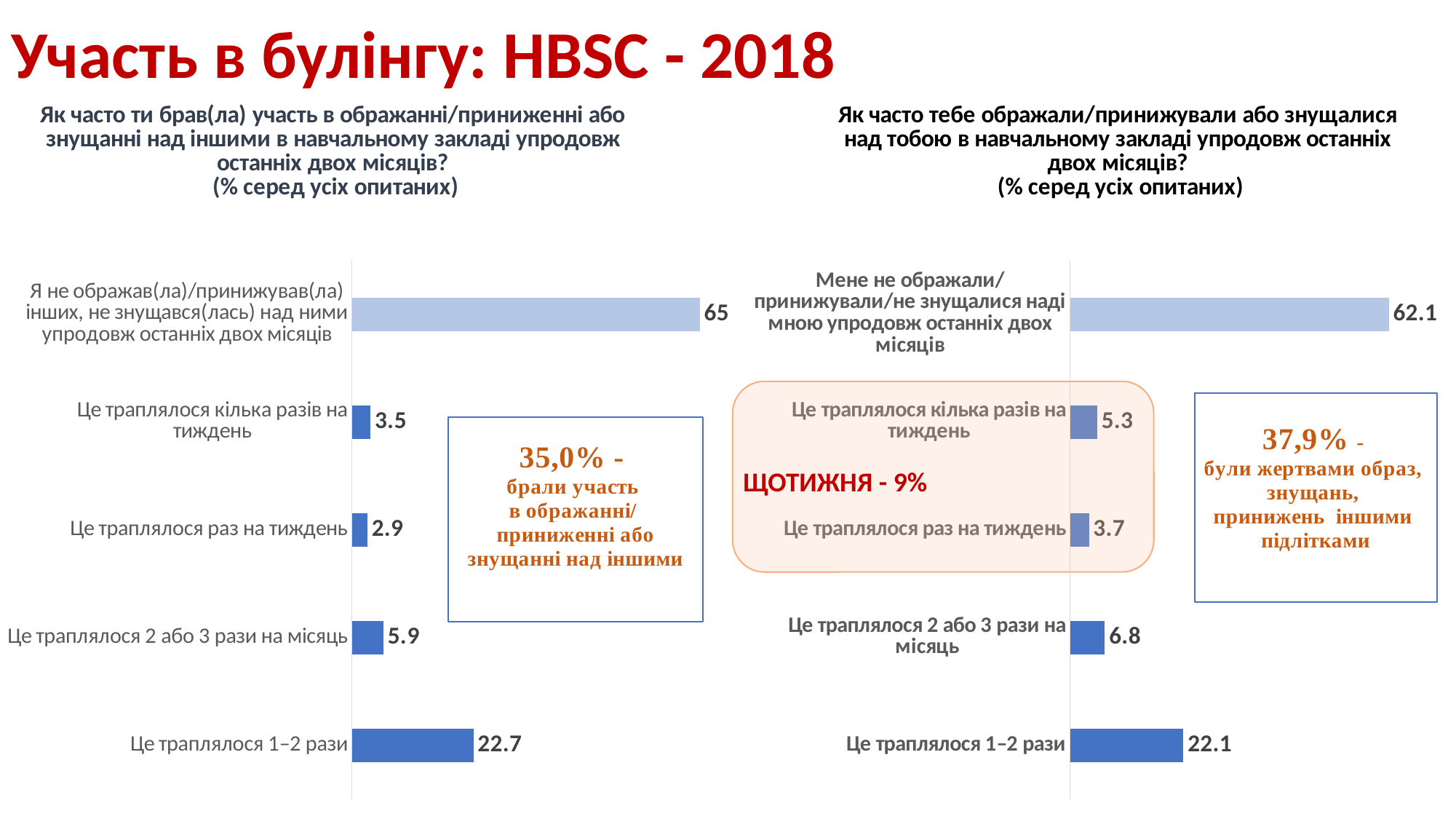
Which is larger: the value for "Це траплялося 1–2 рази" in the left chart or in the right chart? Left chart (22.7) In the right chart, what is the difference between the values for "Це траплялося 1–2 рази" and "Це траплялося 2 або 3 рази на місяць"? 15.3 In the left chart, which category has the lowest value? Це траплялося раз на тиждень In the left chart, which category has the highest value? Я не ображав(ла)/принижував(ла) інших, не знущався(лась) над ними упродовж останніх двох місяців What type of chart is the left chart? Bar chart In the right chart, which category has the lowest value? Це траплялося раз на тиждень In the right chart, what is the value for "Це траплялося 2 або 3 рази на місяць"? 6.8 How many categories does the right chart show? 5 What percentage is shown in the text box on the right chart as having been victims of insults, bullying or humiliation by other teenagers? 37,9% In the right chart, what is the value for "Це траплялося кілька разів на тиждень"? 5.3 In the left chart, what is the value for "Це траплялося 1–2 рази"? 22.7 In the left chart, what is the difference between the values for "Це траплялося 2 або 3 рази на місяць" and "Це траплялося кілька разів на тиждень"? 2.4